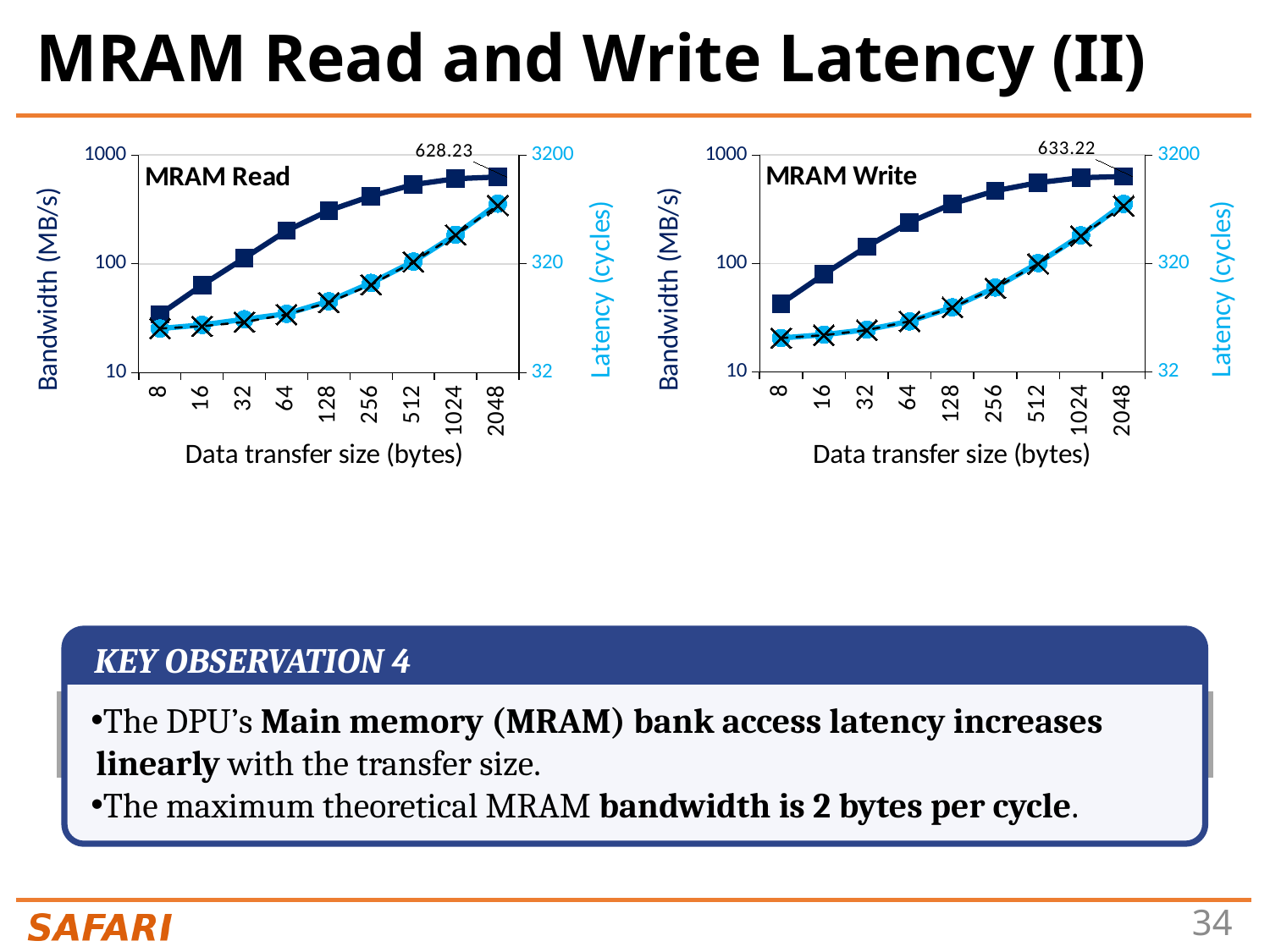
What is the difference between the labeled bandwidth at 2048 bytes in the MRAM Write chart and in the MRAM Read chart? 4.99 In the MRAM Read chart, does bandwidth rise or fall as the data transfer size increases? Rises What is the label of the right-hand vertical axis in the MRAM Write chart? Latency (cycles) In the MRAM Read chart, how many data transfer sizes are plotted on the x axis? 9 In the MRAM Write chart, what is the bandwidth value labeled at a data transfer size of 2048 bytes? 633.22 In the MRAM Read chart, what is the bandwidth value labeled at a data transfer size of 2048 bytes? 628.23 In the MRAM Write chart, is the bandwidth at a data transfer size of 512 bytes greater or less than 100 MB/s? greater In the MRAM Write chart, does latency rise or fall as the data transfer size increases? Rises Which chart shows the larger labeled bandwidth at 2048 bytes, MRAM Read or MRAM Write? MRAM Write What kind of chart is the MRAM Write chart? Line chart In the MRAM Read chart, is the bandwidth at a data transfer size of 8 bytes greater or less than 100 MB/s? less In the MRAM Read chart, at which data transfer size is the bandwidth highest? 2048